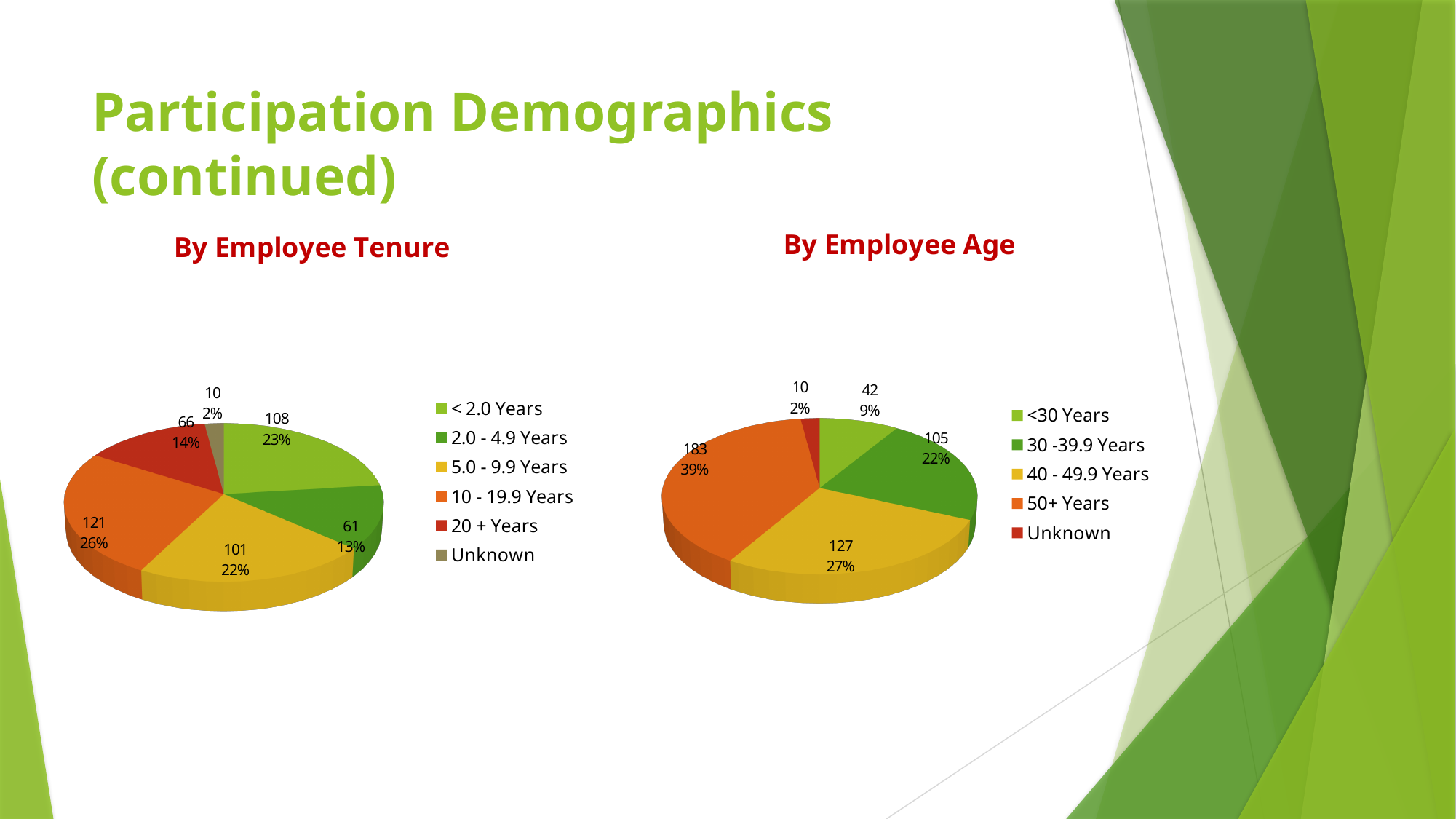
In the By Employee Tenure chart, what is the difference between the values for < 2.0 Years and 2.0 - 4.9 Years? 47 In the By Employee Tenure chart, what percentage share does the 5.0 - 9.9 Years slice have? 22% In the By Employee Tenure chart, which category has the lowest value? Unknown In the By Employee Tenure chart, what colour is the 20 + Years slice? Red In the By Employee Tenure chart, what is the value for 10 - 19.9 Years? 121 In the By Employee Age chart, which category has the highest value? 50+ Years In the By Employee Age chart, which is larger: 30 -39.9 Years or 40 - 49.9 Years? 40 - 49.9 Years What type of chart is the By Employee Age chart? Pie chart In the By Employee Age chart, what is the value for 50+ Years? 183 In the By Employee Age chart, what percentage share does the <30 Years slice have? 9% In the By Employee Tenure chart, how many categories does the legend list? 6 In the By Employee Age chart, what is the difference between the values for 50+ Years and 40 - 49.9 Years? 56